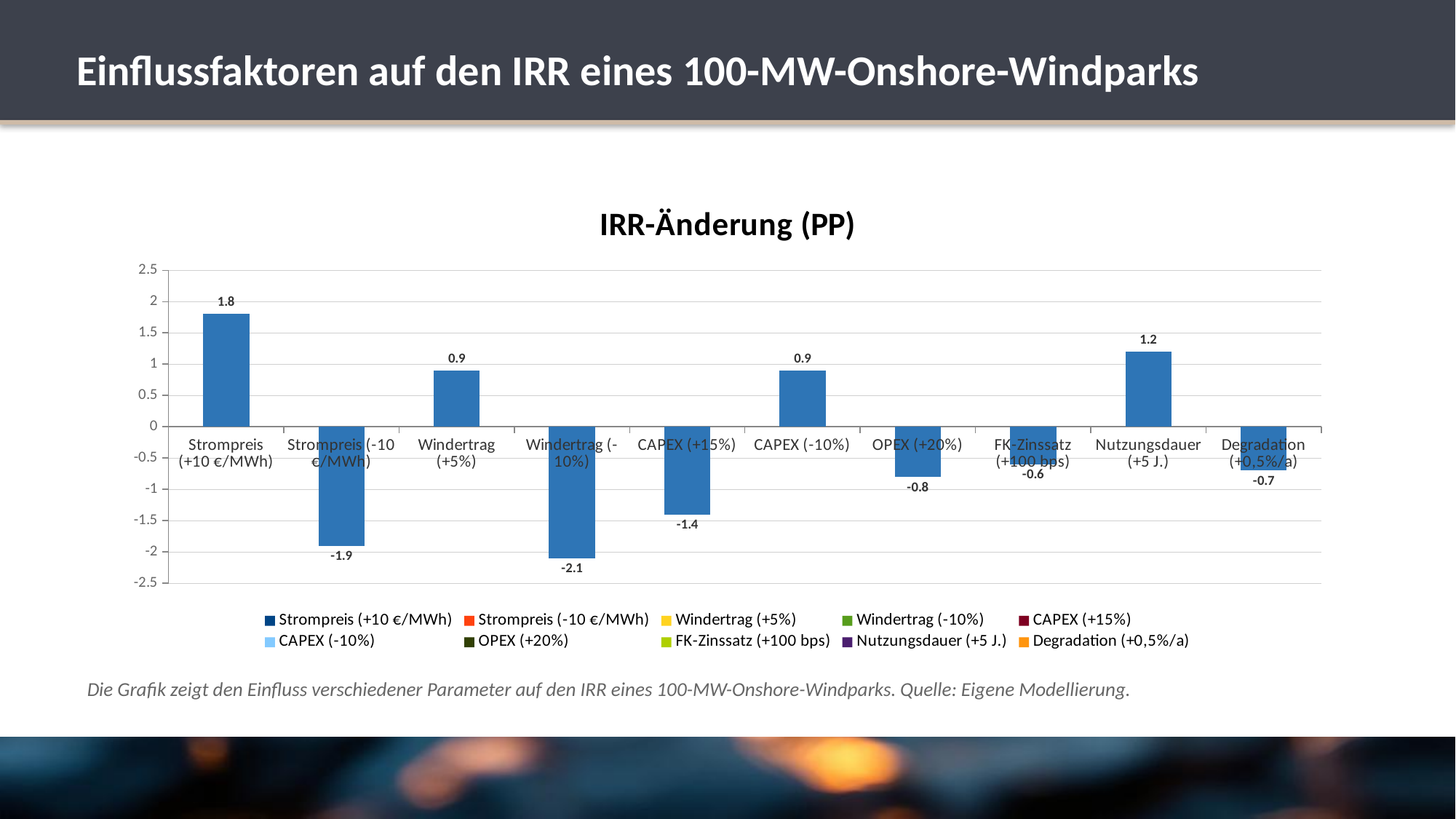
What is the difference between the IRR change for Strompreis (+10 €/MWh) and Nutzungsdauer (+5 J.)? 0.6 What is the IRR change for Nutzungsdauer (+5 J.)? 1.2 What is the title of the chart? IRR-Änderung (PP) What is the IRR change for OPEX (+20%)? -0.8 What kind of chart is shown on the slide? bar chart What is the IRR change for Windertrag (-10%)? -2.1 What is the IRR change for Strompreis (+10 €/MWh)? 1.8 Which category has the lowest IRR change? Windertrag (-10%) Which category has the highest IRR change? Strompreis (+10 €/MWh) Is the value for CAPEX (+15%) greater or less than -1? less How many categories are shown in the chart? 10 Which has a larger IRR change, CAPEX (-10%) or Nutzungsdauer (+5 J.)? Nutzungsdauer (+5 J.)